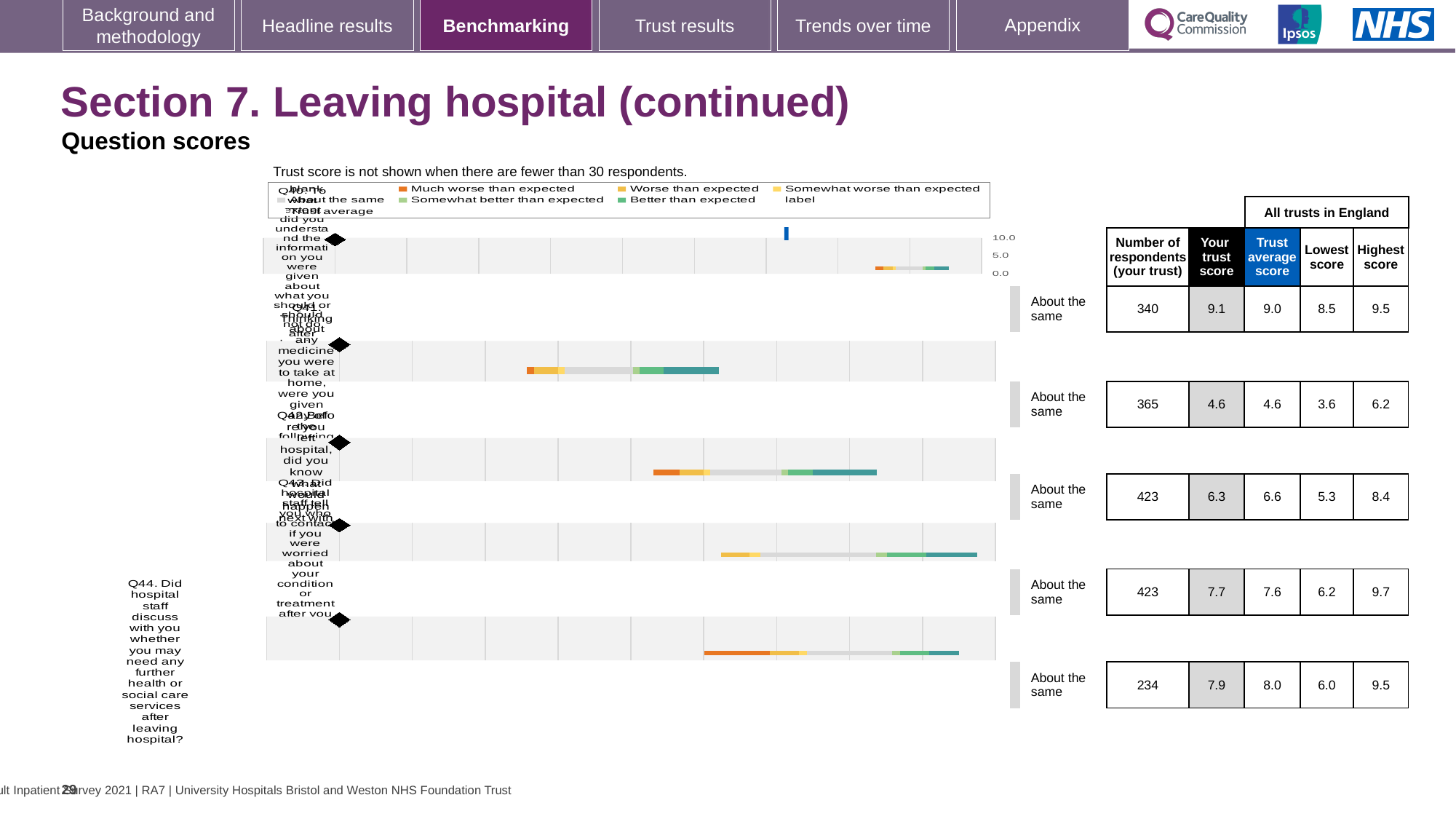
What is the trust score for Q44 (further health or social care services after leaving hospital)? 7.9 What comparison label is shown next to the chart for Q44? About the same What is the number of respondents in the top row of the table? 340 What is the highest 'Your trust score' value shown in the table? 9.1 How many question rows are shown in the chart and table? 5 What is the number of respondents for Q44 (further health or social care services after leaving hospital)? 234 For Q44, which is larger: the trust score or the trust average score? Trust average score What is the lowest 'Your trust score' value shown in the table? 4.6 What is the difference between the highest score and the lowest score for Q44? 3.5 What type of chart is used to show the question scores on this slide? bar chart What is the highest score across all trusts in England for Q44? 9.5 What is the trust average score for Q44? 8.0